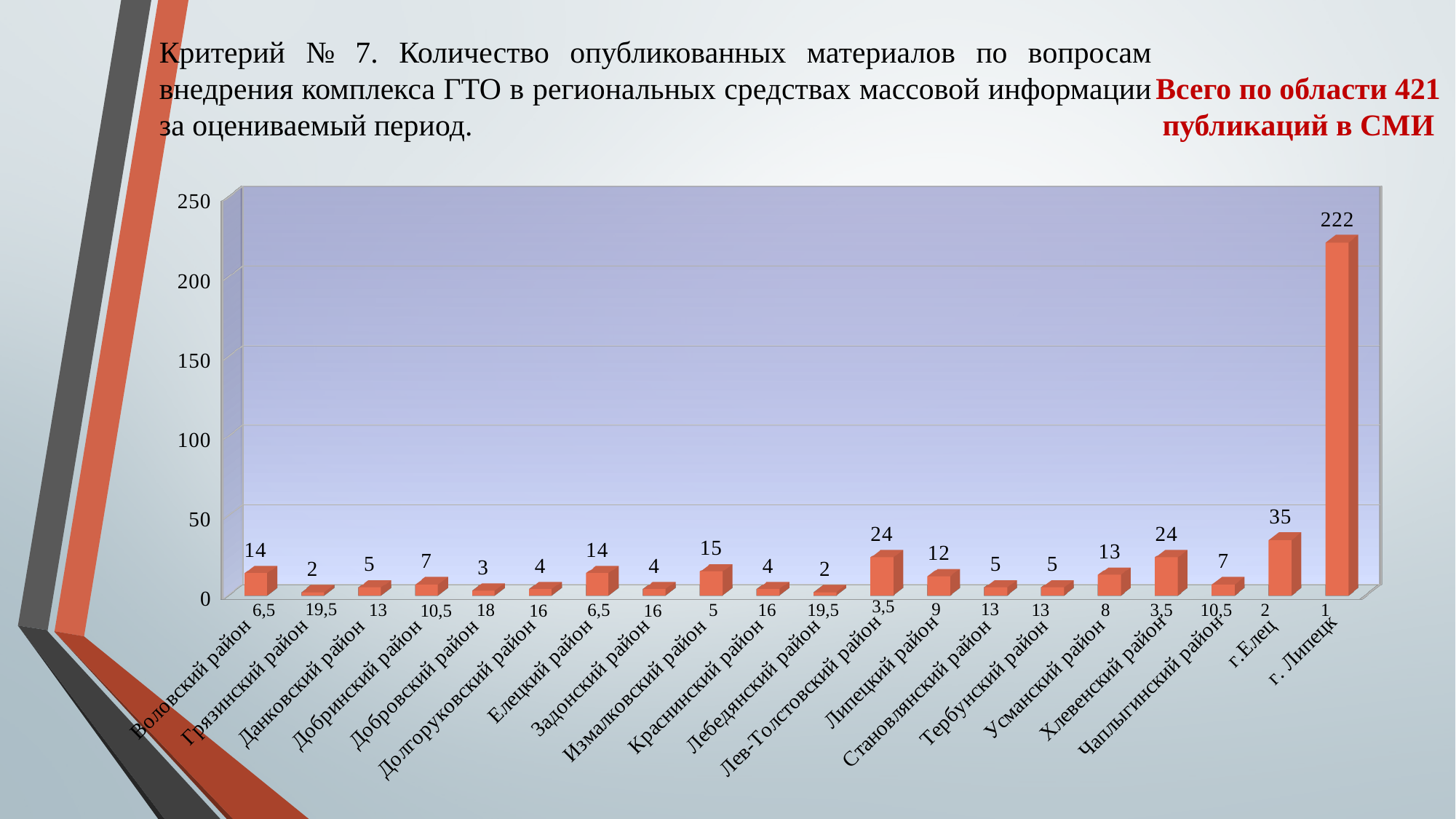
What is the lowest value shown on the chart? 2 What is the value for г.Елец? 35 What is the value for Измалковский район? 15 How many categories are shown on the x axis? 20 Which category has the highest value? г. Липецк Which is larger, the value for Измалковский район or Усманский район? Измалковский район What is the value for Лев-Толстовский район? 24 What type of chart is shown on the slide? bar chart What is the difference between the values for Хлевенский район and Липецкий район? 12 What is the value for г. Липецк? 222 What is the difference between the values for г. Липецк and г.Елец? 187 Is the value for г. Липецк greater or less than 200? greater